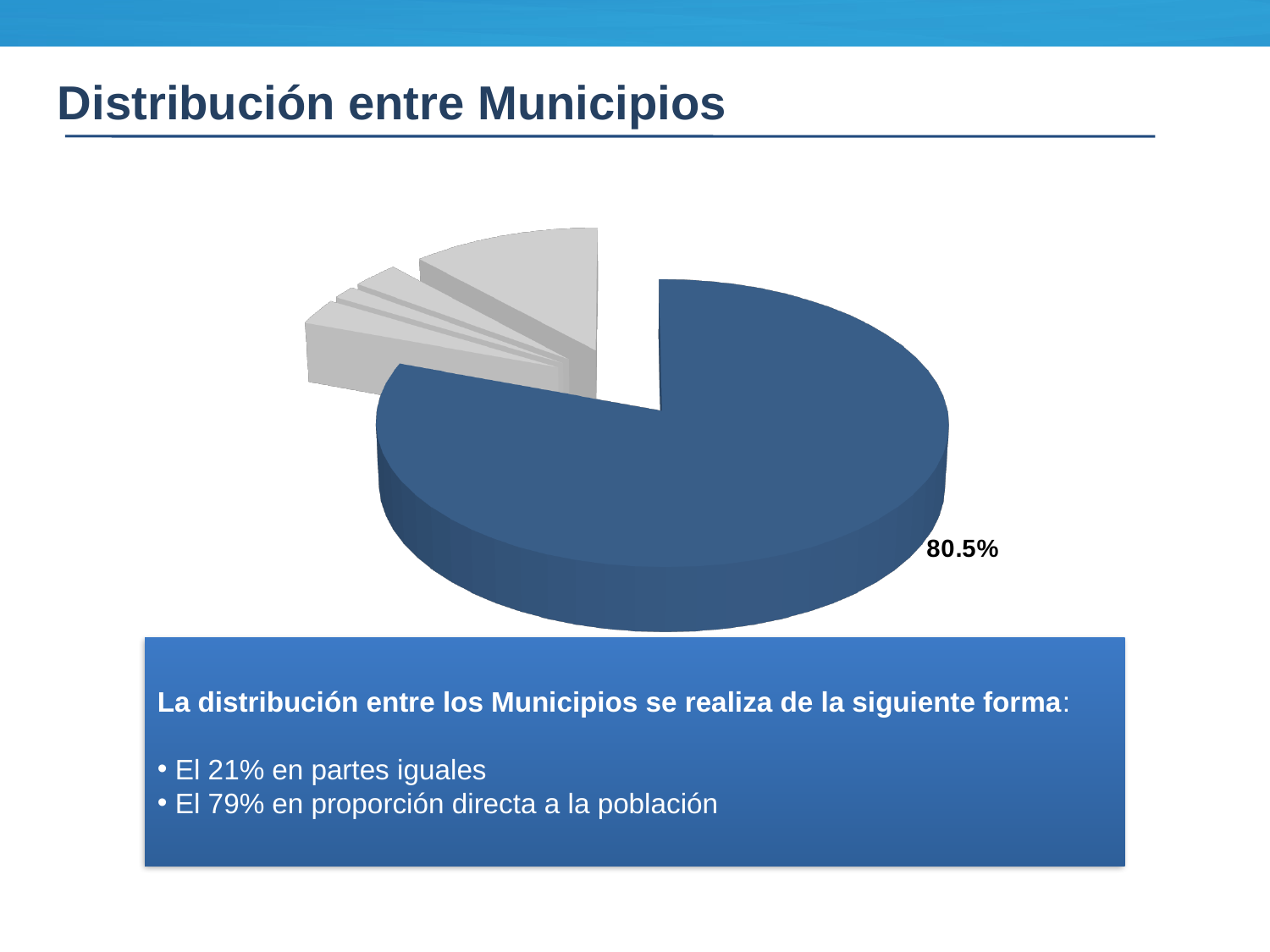
How many data labels are printed on the pie chart? 1 Which slice of the pie chart is the largest, the blue one or one of the grey ones? the blue one What colour is the largest slice of the pie chart? blue Is the share of the blue slice greater or less than 50%? greater What share of the pie does the largest slice represent? 80.5% What percentage is printed on the large blue slice of the pie chart? 80.5% What kind of chart is shown on the slide? pie chart